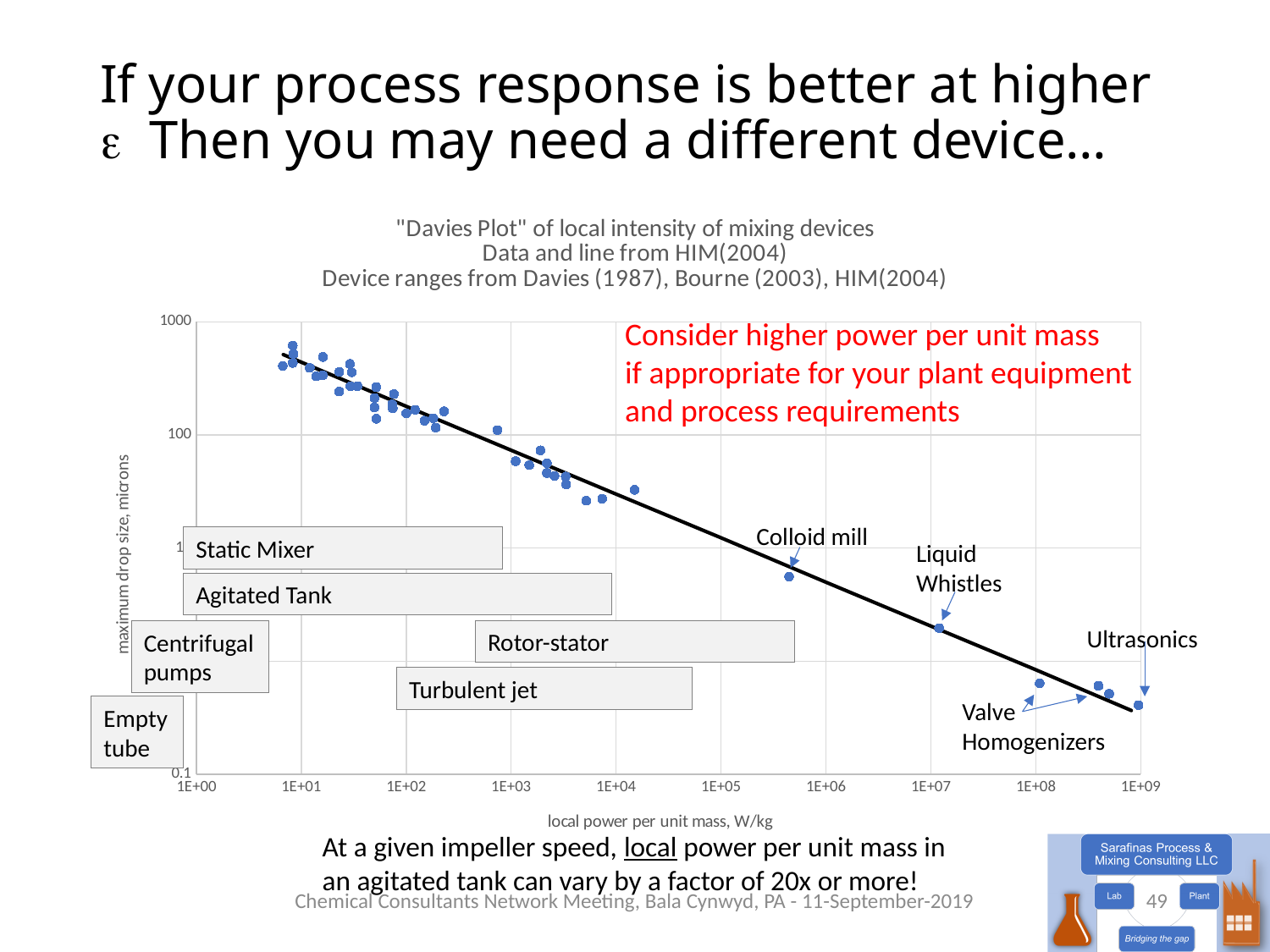
What is the label of the x axis of the chart? local power per unit mass, W/kg Are the maximum drop sizes for the points near 1E+01 W/kg greater or less than 100 microns? greater Is the maximum drop size for the Ultrasonics point near 1E+09 W/kg greater or less than 100 microns? less Is the maximum drop size for the Colloid mill point greater or less than 100 microns? less As local power per unit mass increases along the x axis, does the maximum drop size rise or fall? fall Which has the larger maximum drop size: the Colloid mill point or the Ultrasonics point? Colloid mill What is the label of the y axis of the chart? maximum drop size, microns What kind of chart is shown on the slide? scatter chart